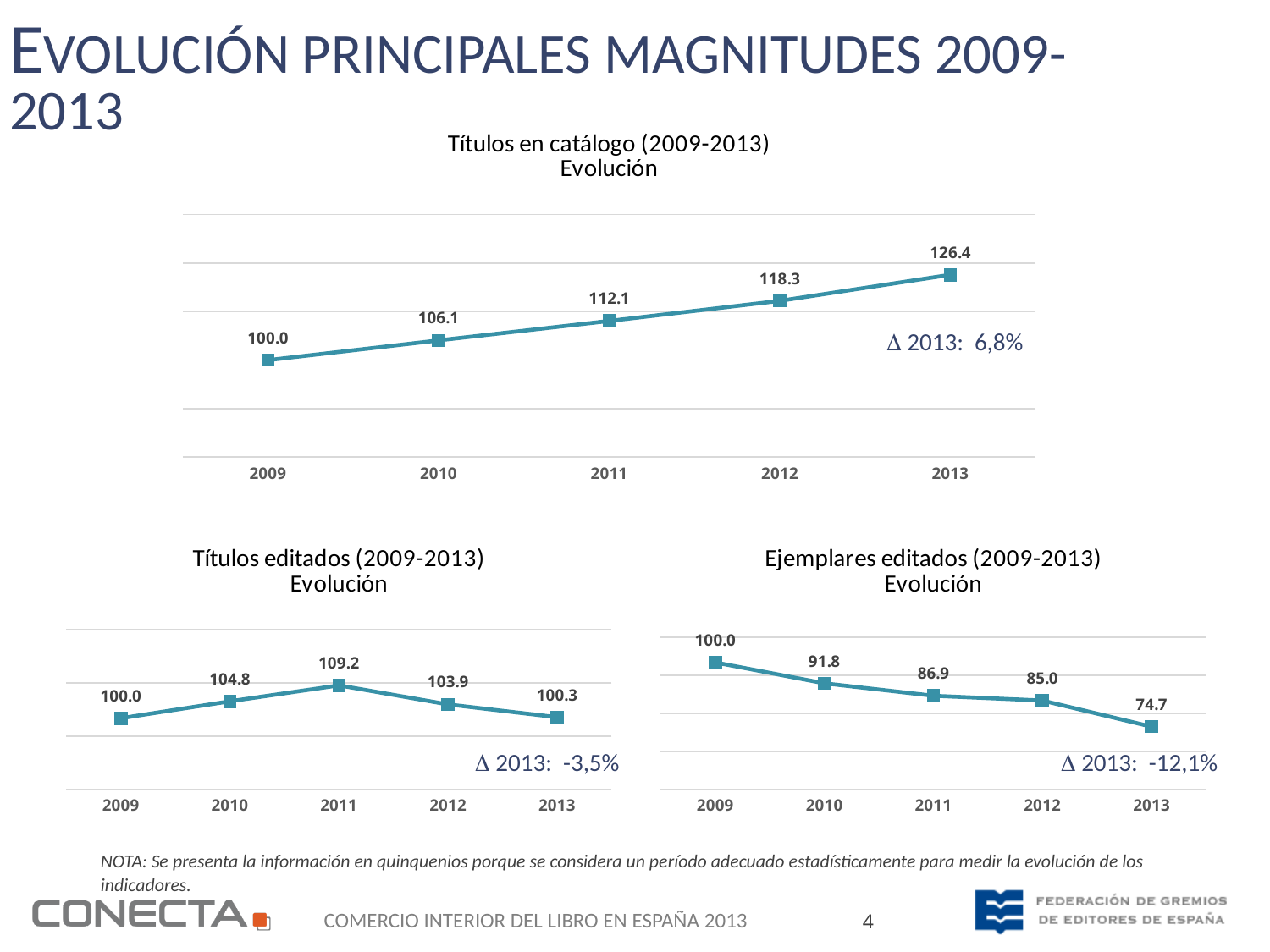
In the 'Títulos en catálogo (2009-2013) Evolución' chart, do the values rise or fall from 2009 to 2013? rise What kind of chart is the 'Títulos en catálogo (2009-2013) Evolución' chart? line chart In the 'Ejemplares editados (2009-2013) Evolución' chart, do the values rise or fall from 2009 to 2013? fall In the 'Ejemplares editados (2009-2013) Evolución' chart, what is the difference between the 2010 and 2011 values? 4.9 In the 'Títulos en catálogo (2009-2013) Evolución' chart, what is the value for 2013? 126.4 In the 'Títulos editados (2009-2013) Evolución' chart, which year has the lowest value? 2009 In the 'Ejemplares editados (2009-2013) Evolución' chart, what is the value for 2013? 74.7 In the 'Títulos editados (2009-2013) Evolución' chart, what is the value for 2012? 103.9 In the 'Títulos en catálogo (2009-2013) Evolución' chart, what is the value for 2011? 112.1 In the 'Títulos en catálogo (2009-2013) Evolución' chart, what is the difference between the 2013 and 2009 values? 26.4 In the 'Títulos editados (2009-2013) Evolución' chart, which year has the highest value? 2011 How many data points are plotted in the 'Ejemplares editados (2009-2013) Evolución' chart? 5